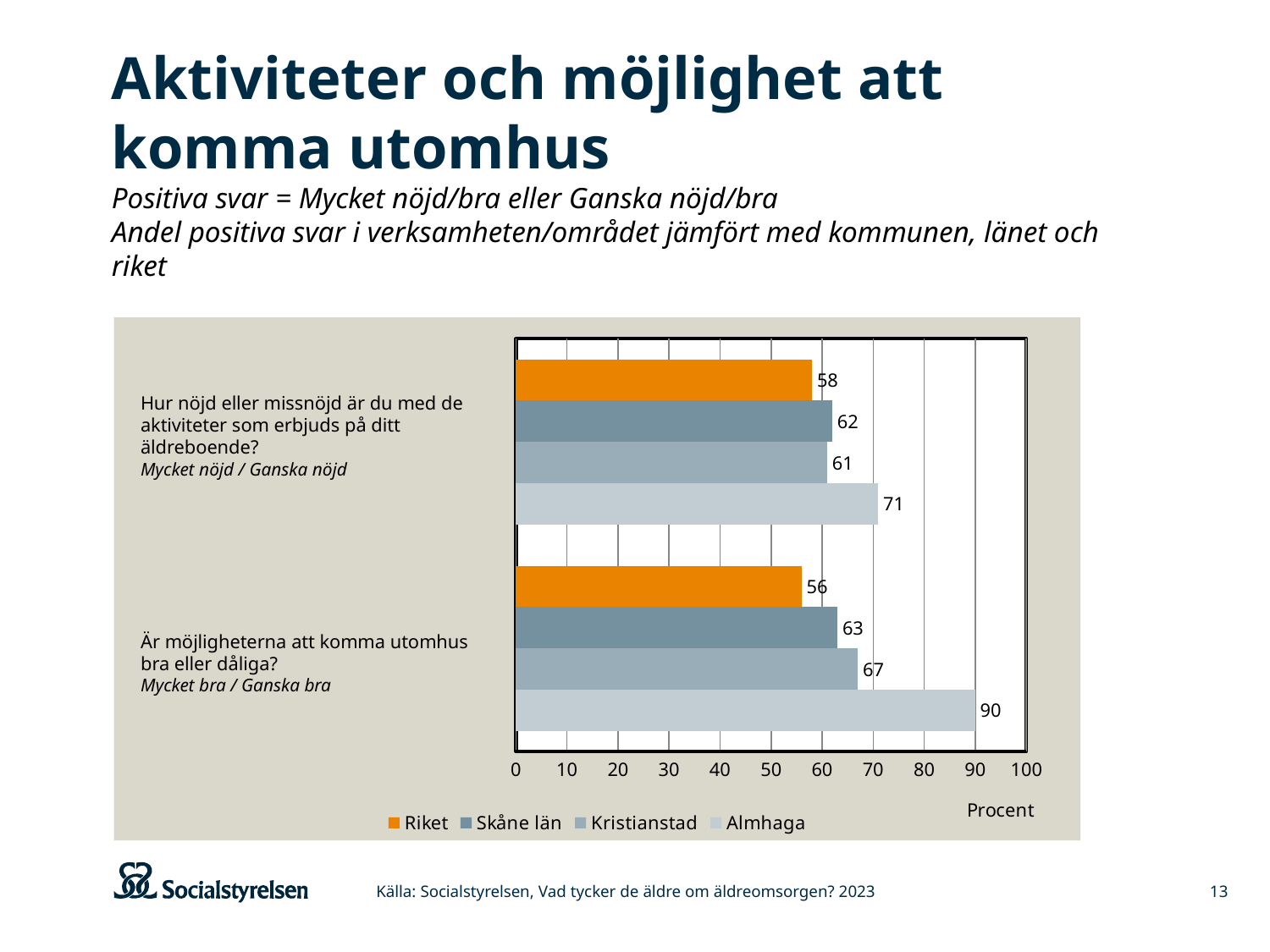
Which series has the lowest value on the question about satisfaction with activities offered? Riket How many series does the legend list? 4 What is the value for Riket on the question about satisfaction with activities offered at the care home? 58 What unit is shown on the x axis of the chart? Procent Which series has the highest value on the question about opportunities to get outdoors? Almhaga What kind of chart is shown on the slide? Bar chart What is the value for Almhaga on the question about opportunities to get outdoors ("Är möjligheterna att komma utomhus bra eller dåliga?")? 90 How many survey questions (categories) are shown in the chart? 2 What is the difference between Almhaga and Riket on the question about opportunities to get outdoors? 34 Which is larger: Almhaga's value for activities offered or Almhaga's value for opportunities to get outdoors? Opportunities to get outdoors (90) What is the value for Kristianstad on the question about opportunities to get outdoors? 67 What is the value for Skåne län on the question about satisfaction with activities offered? 62